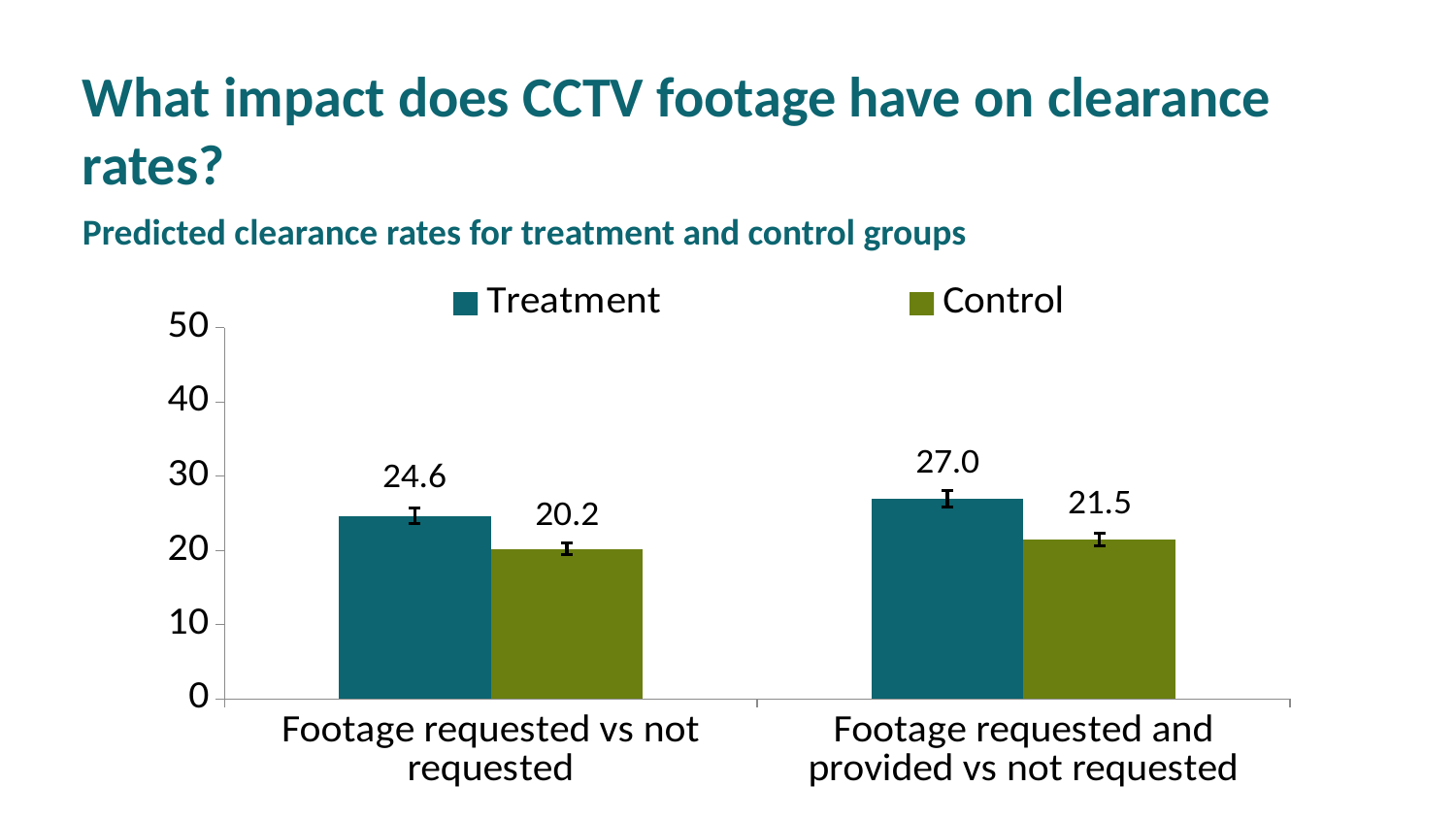
What is the Treatment value for "Footage requested vs not requested"? 24.6 Which category has the lowest Control value? Footage requested vs not requested How many categories are shown on the x axis? 2 What is the Control value for "Footage requested and provided vs not requested"? 21.5 Which category has the highest Treatment value? Footage requested and provided vs not requested What kind of chart is shown on the slide? Bar chart What is the difference between the Treatment and Control values for "Footage requested and provided vs not requested"? 5.5 What is the Control value for "Footage requested vs not requested"? 20.2 Which is larger: the Treatment value for "Footage requested vs not requested" or the Control value for "Footage requested and provided vs not requested"? Treatment value for "Footage requested vs not requested" How many series does the legend list? 2 What is the Treatment value for "Footage requested and provided vs not requested"? 27.0 What is the difference between the Treatment and Control values for "Footage requested vs not requested"? 4.4